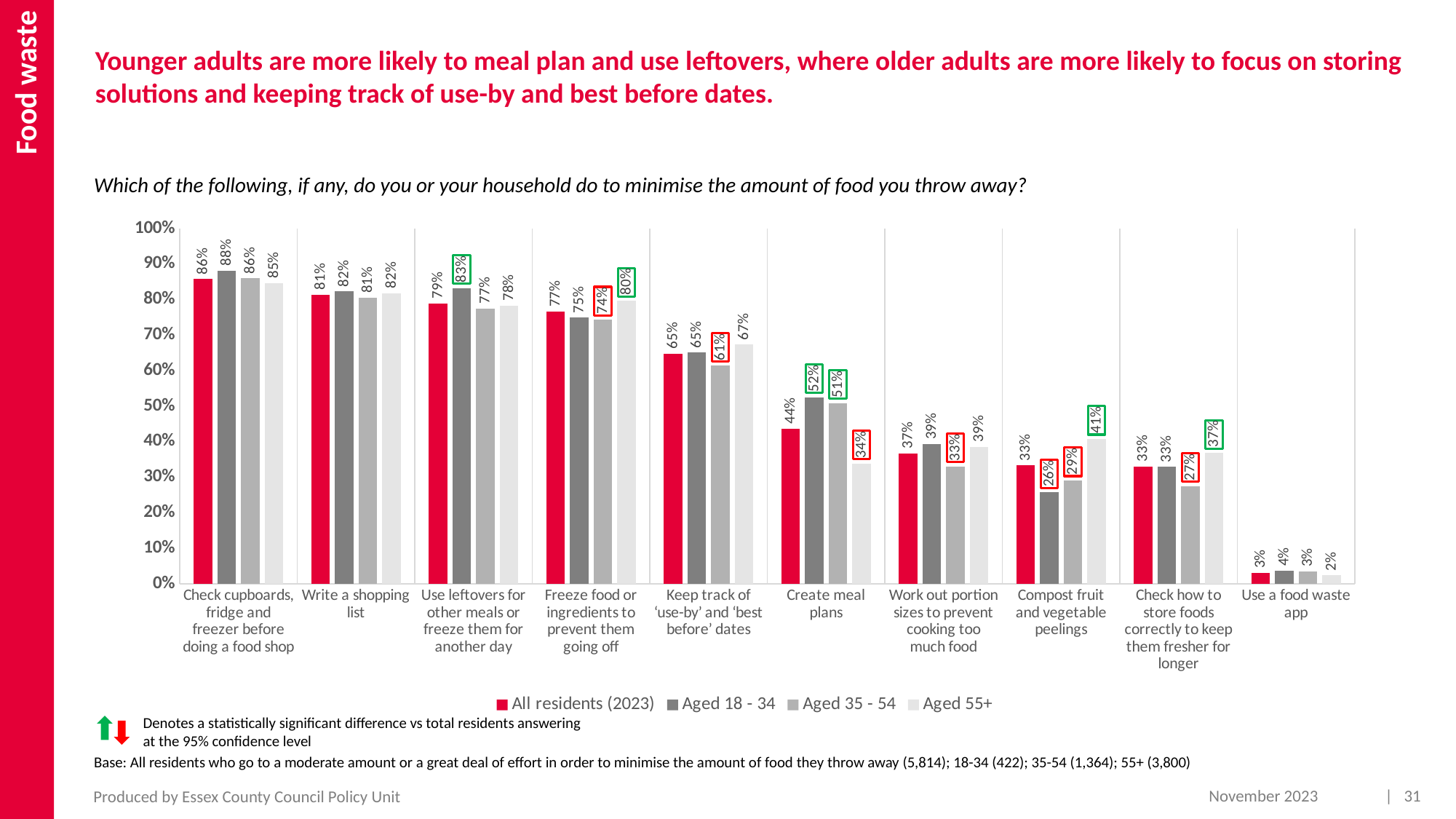
How many series does the legend list? 4 What colour are the bars for the 'All residents (2023)' series? Red What is the value for Aged 55+ for 'Compost fruit and vegetable peelings'? 41% Do the values for all residents (2023) generally rise or fall from left to right across the categories? Fall What is the difference between the Aged 18 - 34 and Aged 55+ values for 'Create meal plans'? 18 percentage points Which category has the lowest value for all residents (2023)? Use a food waste app What is the value for Aged 18 - 34 for 'Use leftovers for other meals or freeze them for another day'? 83% How many categories (activities) are shown on the x axis? 10 Which category has the highest value for all residents (2023)? Check cupboards, fridge and freezer before doing a food shop What kind of chart is shown on the slide? Bar chart For 'Compost fruit and vegetable peelings', which is larger: the Aged 18 - 34 value or the Aged 55+ value? Aged 55+ What percentage of all residents (2023) say they create meal plans? 44%